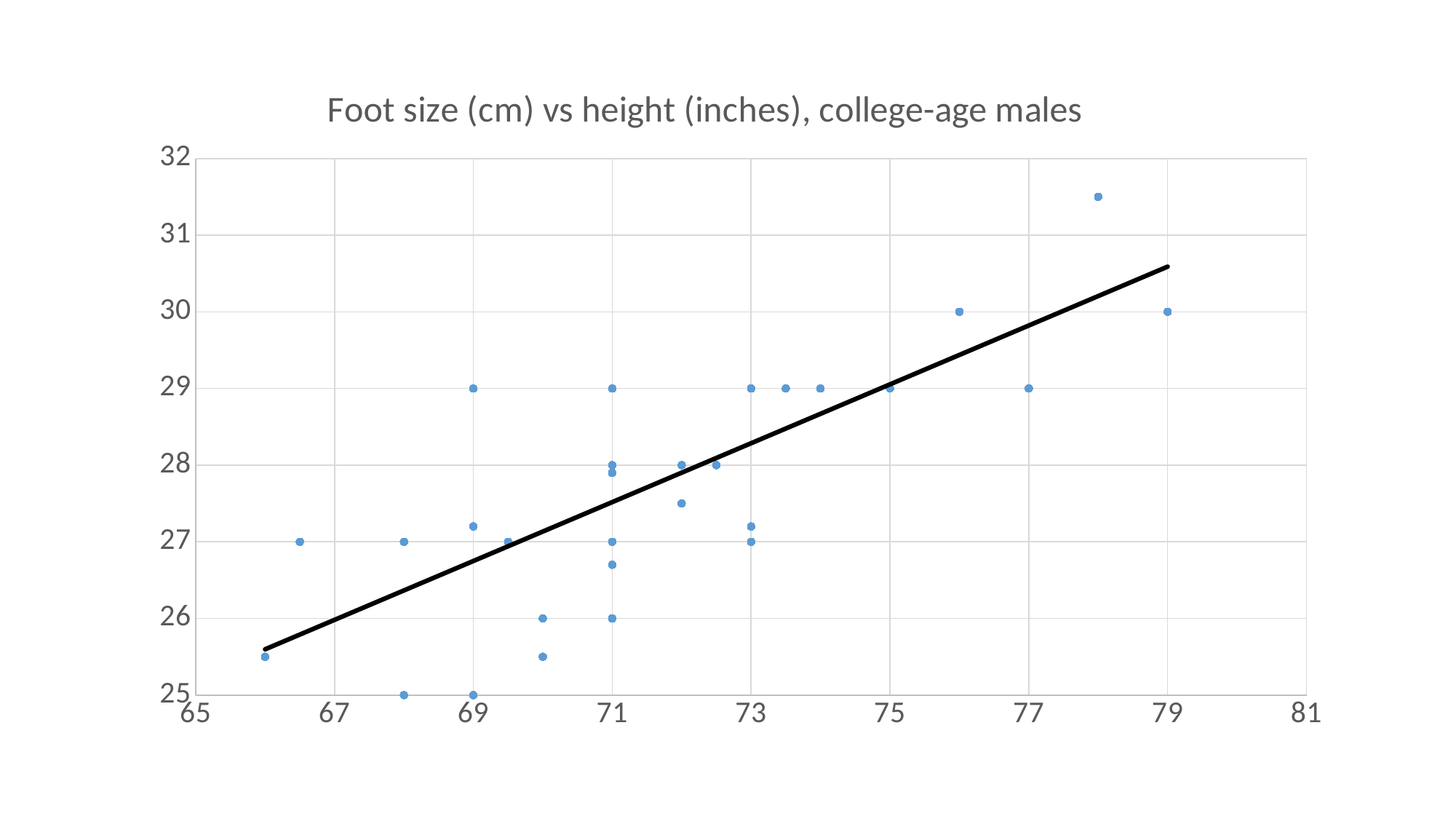
What is the smallest foot size (cm) plotted on the chart? 25 What is the title of the chart? Foot size (cm) vs height (inches), college-age males Which has the larger foot size: the point at height 78 inches or the point at height 79 inches? 78 inches What foot size (cm) is plotted for the point at height 77 inches? 29 What foot size (cm) is plotted for the point at height 76 inches? 30 Is the foot size of the highest plotted point greater or less than 31? greater What kind of chart is shown on the slide? scatter plot Do foot sizes generally rise or fall as height increases along the x axis? rise Is the foot size for the point at height 66 inches greater or less than 26? less What is the difference in foot size (cm) between the point at height 76 inches and the point at height 77 inches? 1 What colour is the trend line drawn through the points? black